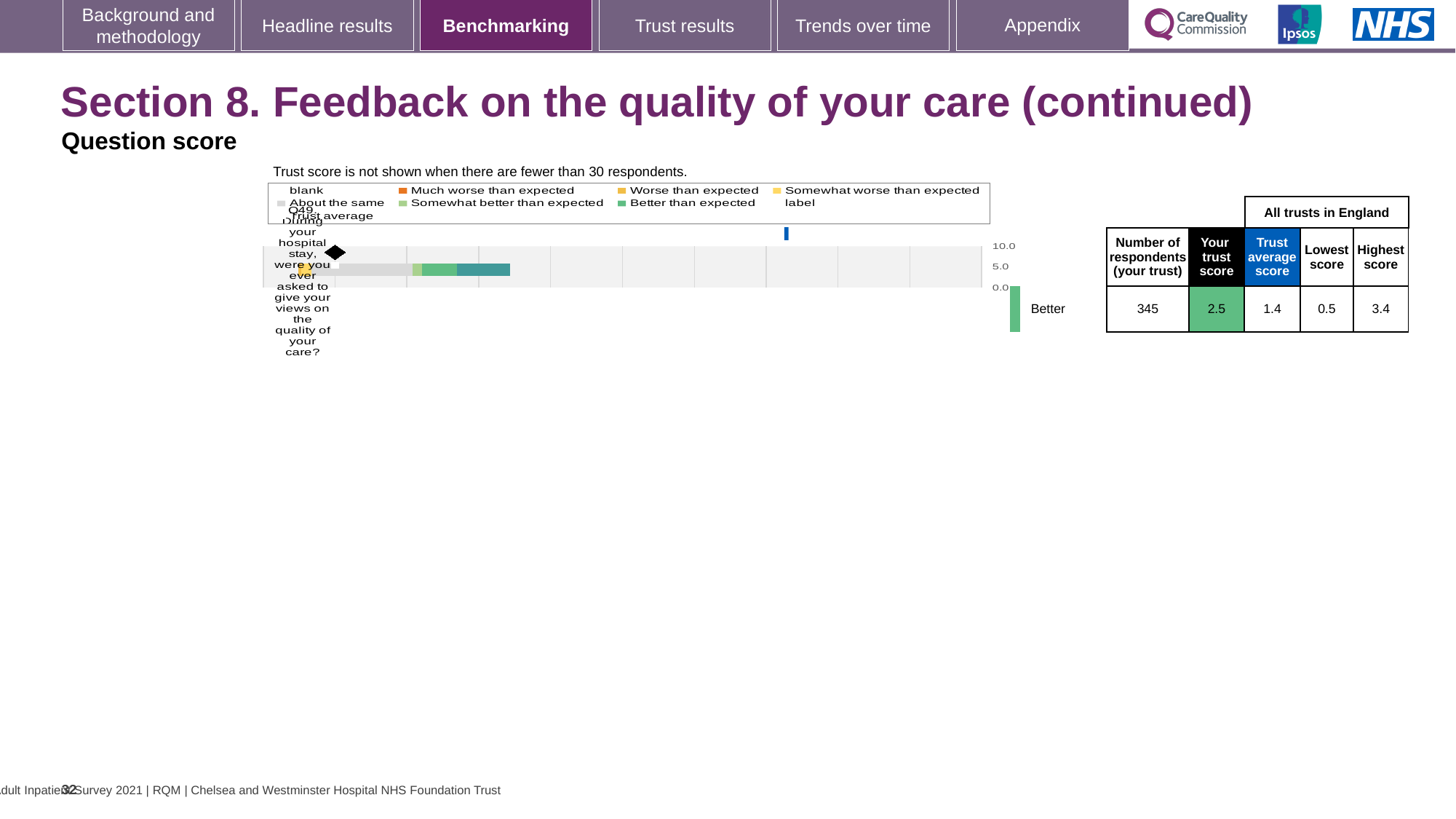
What is the trust average score for Q49 shown alongside the chart? 1.4 What kind of chart is used to show the Q49 benchmarking result? Bar chart What is the highest value shown on the chart's axis? 10.0 Is the trust score marker for Q49 on the chart greater or less than 5.0? less According to the note above the chart, when is the trust score not shown? When there are fewer than 30 respondents What is the trust score for Q49 shown alongside the chart? 2.5 Which is larger for Q49, the trust score or the trust average score? The trust score What is the highest score among all trusts in England for Q49? 3.4 How many respondents from the trust answered Q49? 345 What is the lowest score among all trusts in England for Q49? 0.5 By how much does the trust score for Q49 exceed the trust average score? 1.1 How many questions are plotted in the benchmarking chart? 1